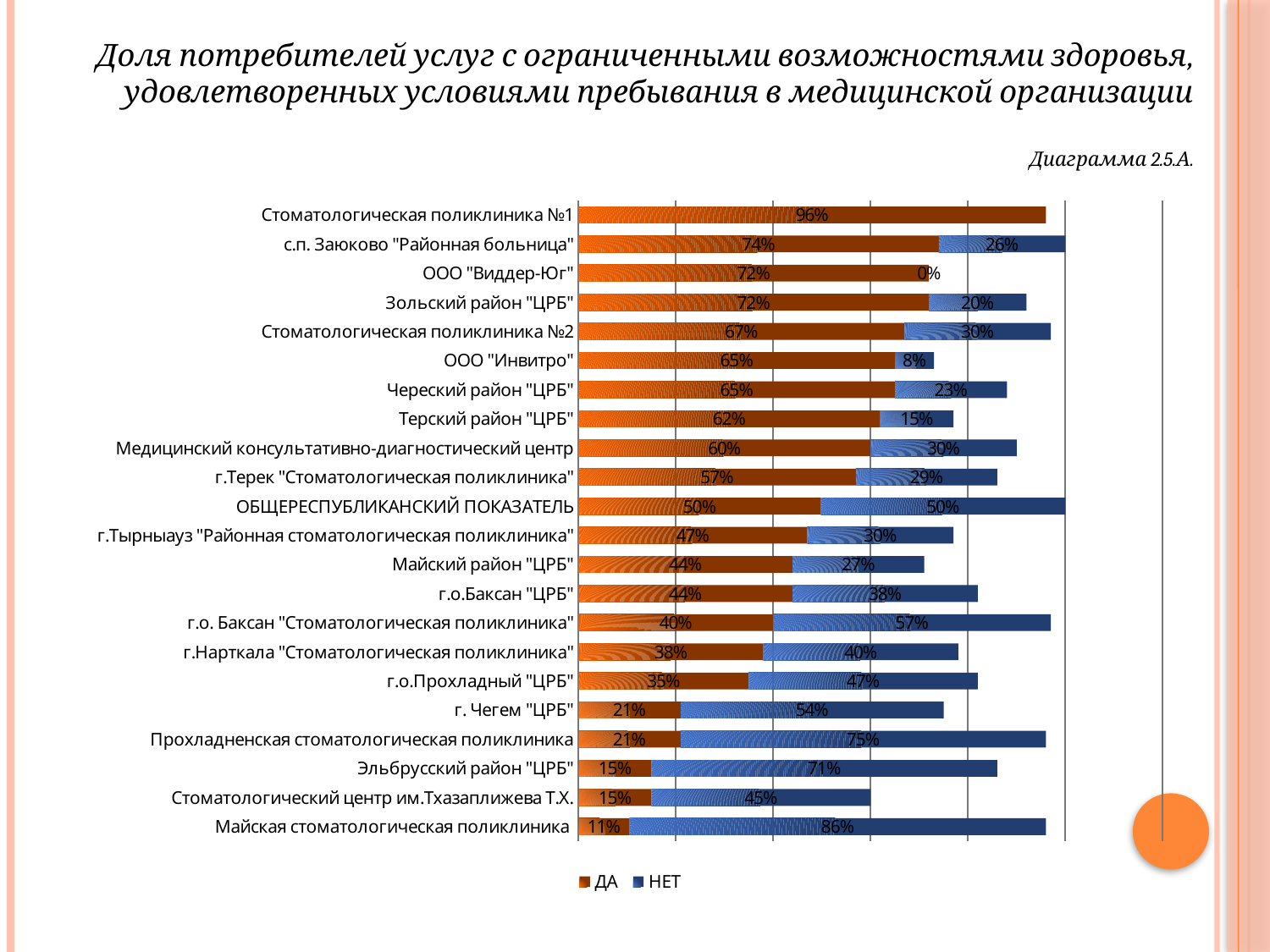
What is the ДА value for Стоматологическая поликлиника №1? 96% What is the НЕТ value for Майская стоматологическая поликлиника? 86% Which has a larger НЕТ value: Прохладненская стоматологическая поликлиника or Эльбрусский район "ЦРБ"? Прохладненская стоматологическая поликлиника How many organisations (categories) are plotted on the chart? 22 What is the difference between the ДА values of с.п. Заюково "Районная больница" and Зольский район "ЦРБ"? 2% What is the ДА value for ОБЩЕРЕСПУБЛИКАНСКИЙ ПОКАЗАТЕЛЬ? 50% What is the total of the ДА and НЕТ values for с.п. Заюково "Районная больница"? 100% How many series does the legend list? 2 Which organisation has the highest ДА value? Стоматологическая поликлиника №1 Which organisation has the lowest ДА value? Майская стоматологическая поликлиника What are the two series named in the legend? ДА and НЕТ What kind of chart is shown on the slide? Stacked bar chart